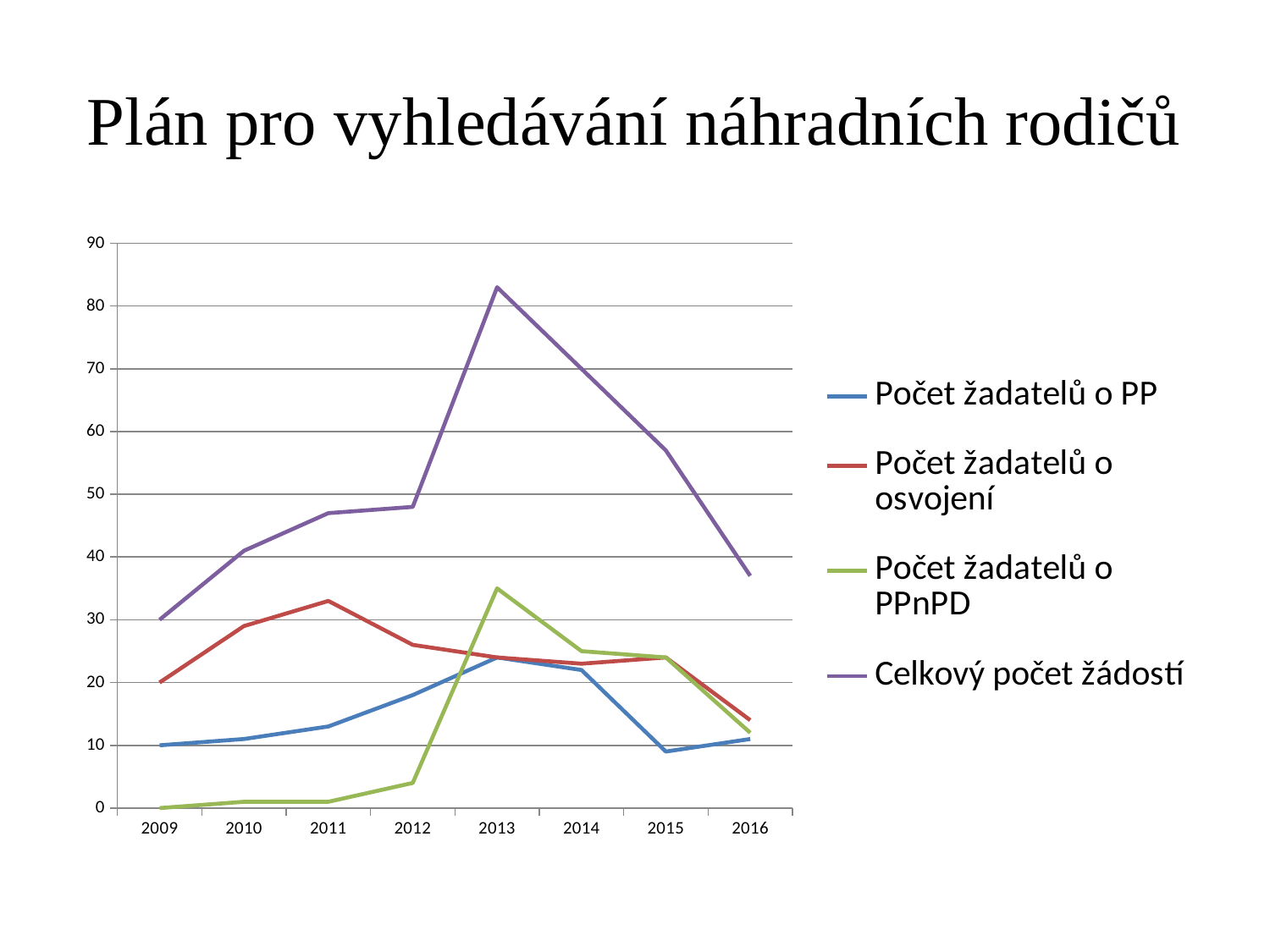
Is the value of Celkový počet žádostí in 2013 greater or less than 80? greater In which year does Celkový počet žádostí reach its highest value? 2013 Does Celkový počet žádostí rise or fall from 2013 to 2016? fall Which series has the higher value in 2012: Počet žadatelů o osvojení or Počet žadatelů o PPnPD? Počet žadatelů o osvojení What kind of chart is shown on the slide? line chart How many years are shown on the x axis? 8 How many series does the legend list? 4 Is the value of Počet žadatelů o PP in 2015 greater or less than 10? less What is the value of Počet žadatelů o PPnPD in 2009? 0 What is the title of the slide? Plán pro vyhledávání náhradních rodičů Is the value of Počet žadatelů o osvojení in 2011 greater or less than 30? greater In which year is Počet žadatelů o PPnPD at its lowest? 2009